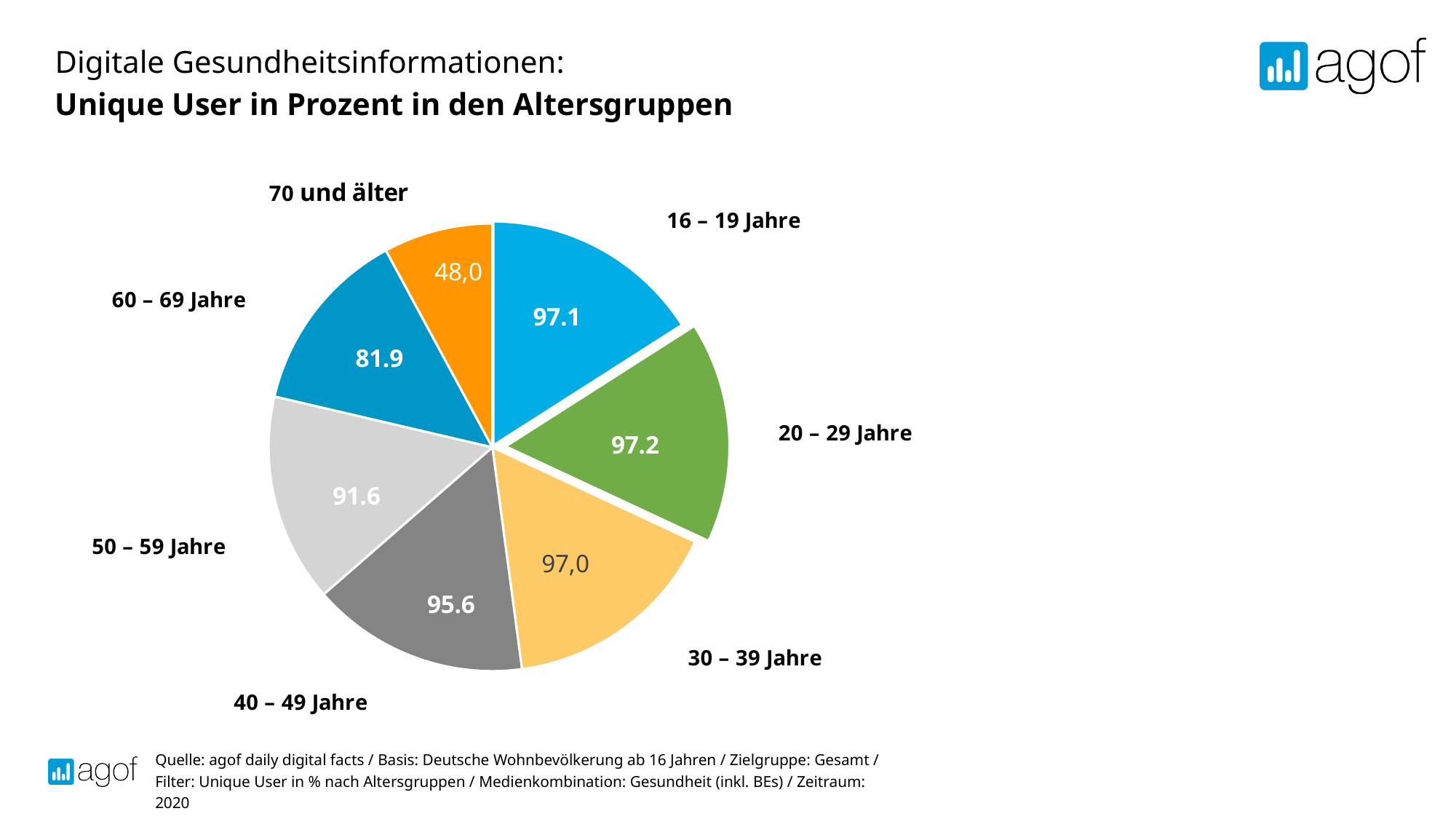
What kind of chart is shown on the slide? pie chart Which age group has the lowest value? 70 und älter What is the value for the 70 und älter slice? 48,0 What is the value for the 50 – 59 Jahre slice? 91.6 How many age groups are shown in the pie chart? 7 What is the value for the 30 – 39 Jahre slice? 97,0 What colour is the 70 und älter slice? orange What is the value for the 16 – 19 Jahre slice? 97.1 What is the difference between the values for 16 – 19 Jahre and 70 und älter? 49.1 Which is larger, the value for 40 – 49 Jahre or the value for 60 – 69 Jahre? 40 – 49 Jahre Which age group has the highest value? 20 – 29 Jahre What is the difference between the values for 50 – 59 Jahre and 60 – 69 Jahre? 9.7